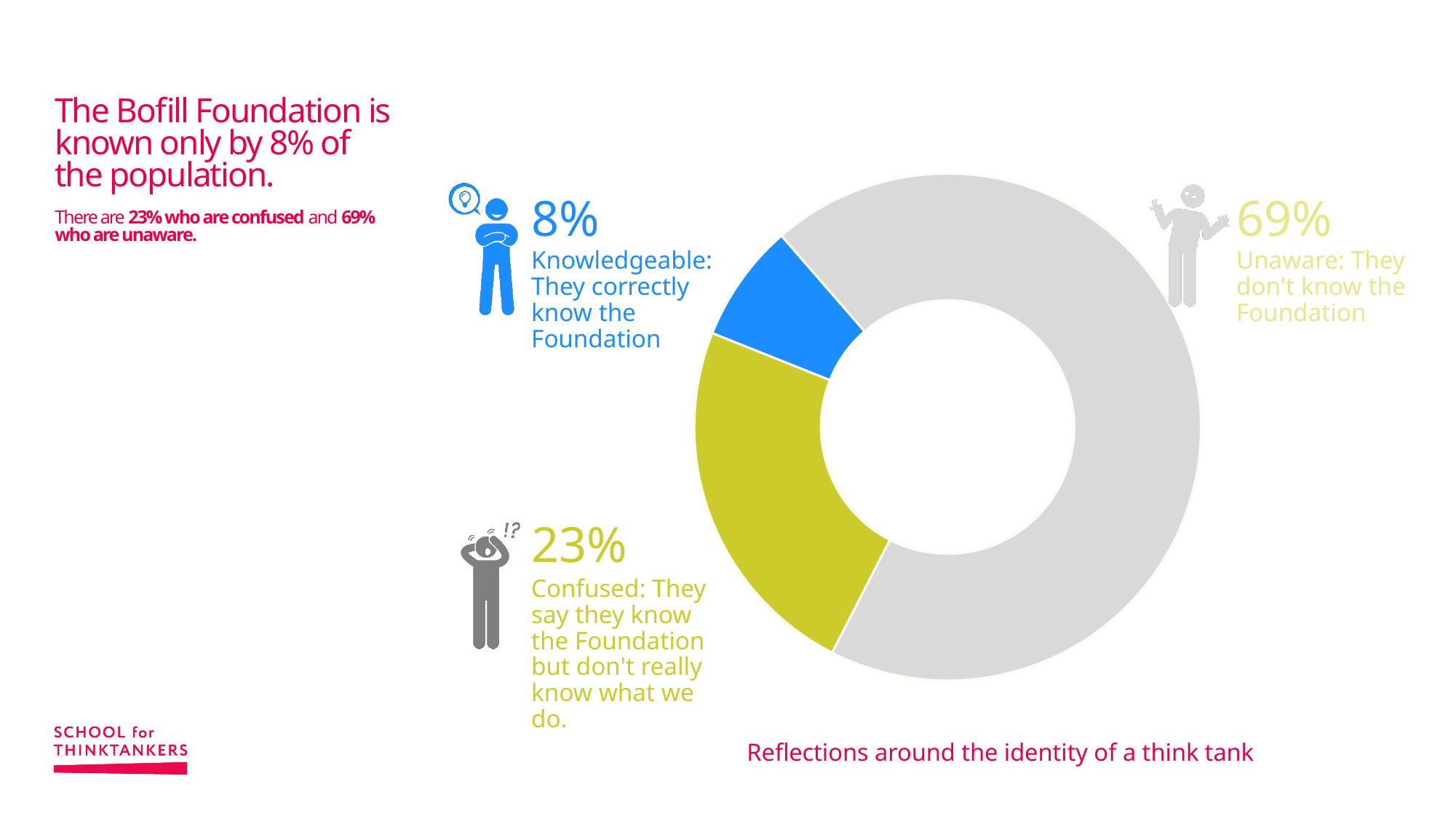
Which category has the largest share of the donut chart? Unaware What kind of chart is shown on the slide? Donut (pie) chart What colour is the Knowledgeable segment of the chart? Blue What percentage of the population is Confused about the Foundation? 23% Which is larger, the Confused share or the Knowledgeable share? Confused What is the difference in percentage points between the Unaware and Confused shares? 46 Which category has the smallest share of the donut chart? Knowledgeable How many categories are shown in the donut chart? 3 What is the difference in percentage points between the Confused and Knowledgeable shares? 15 What colour is the Unaware segment of the chart? Grey What percentage of the population is Unaware of the Foundation? 69% What percentage of the population is Knowledgeable about the Foundation? 8%